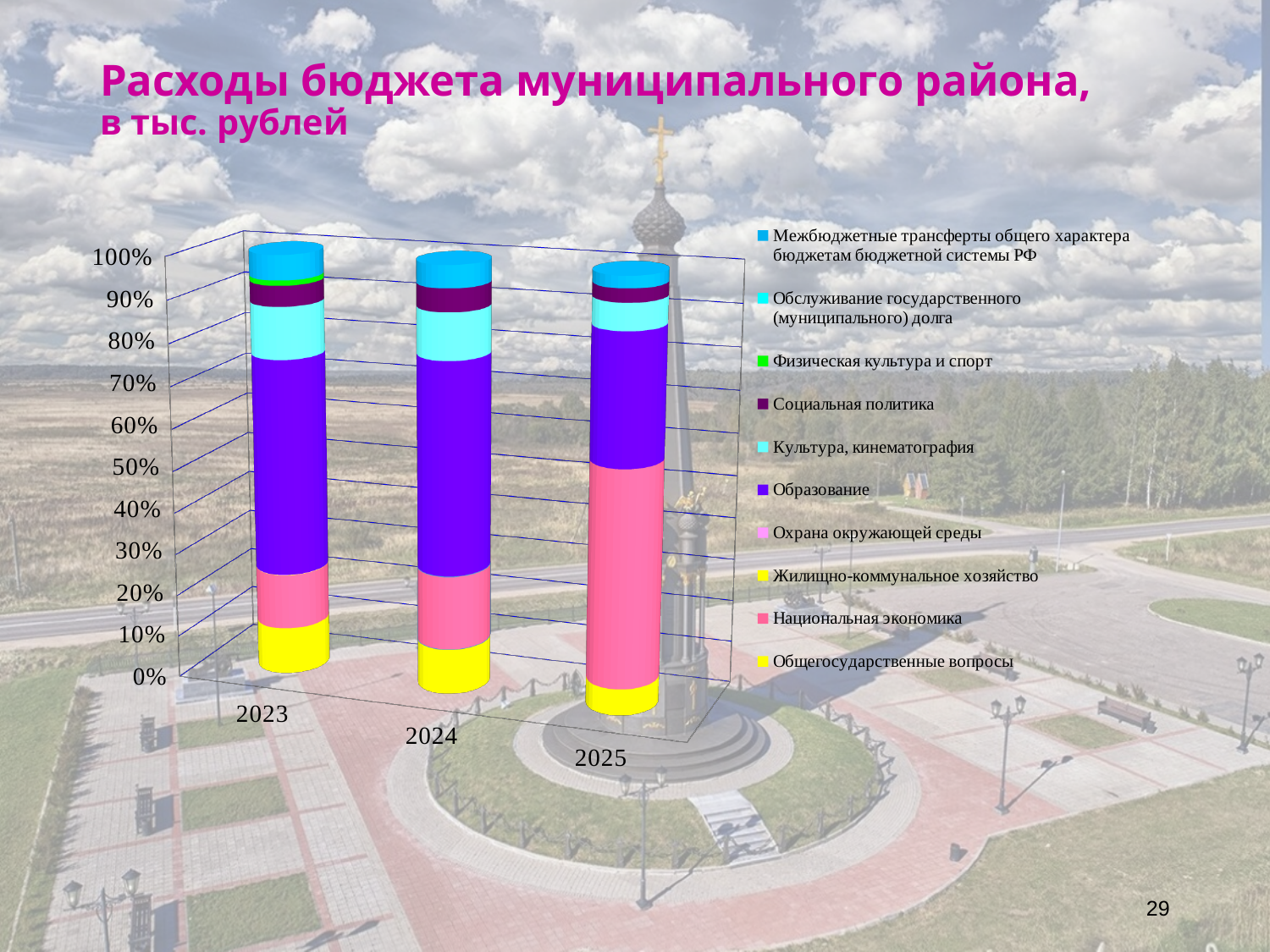
Which legend entry is shown in yellow? Общегосударственные вопросы Is the share of Общегосударственные вопросы in 2024 greater or less than 20%? less Is the share of Образование larger in 2023 or in 2025? 2023 How many series does the chart legend list? 10 Is the share of Национальная экономика in 2023 greater or less than 30%? less Is the share of Национальная экономика larger in 2024 or in 2025? 2025 How many years are shown on the x axis of the chart? 3 What is the title of the chart on the slide? Расходы бюджета муниципального района, в тыс. рублей Is the share of Образование in 2023 greater or less than 40%? greater Which year has the largest share for Национальная экономика? 2025 What kind of chart is shown on the slide? Stacked bar chart